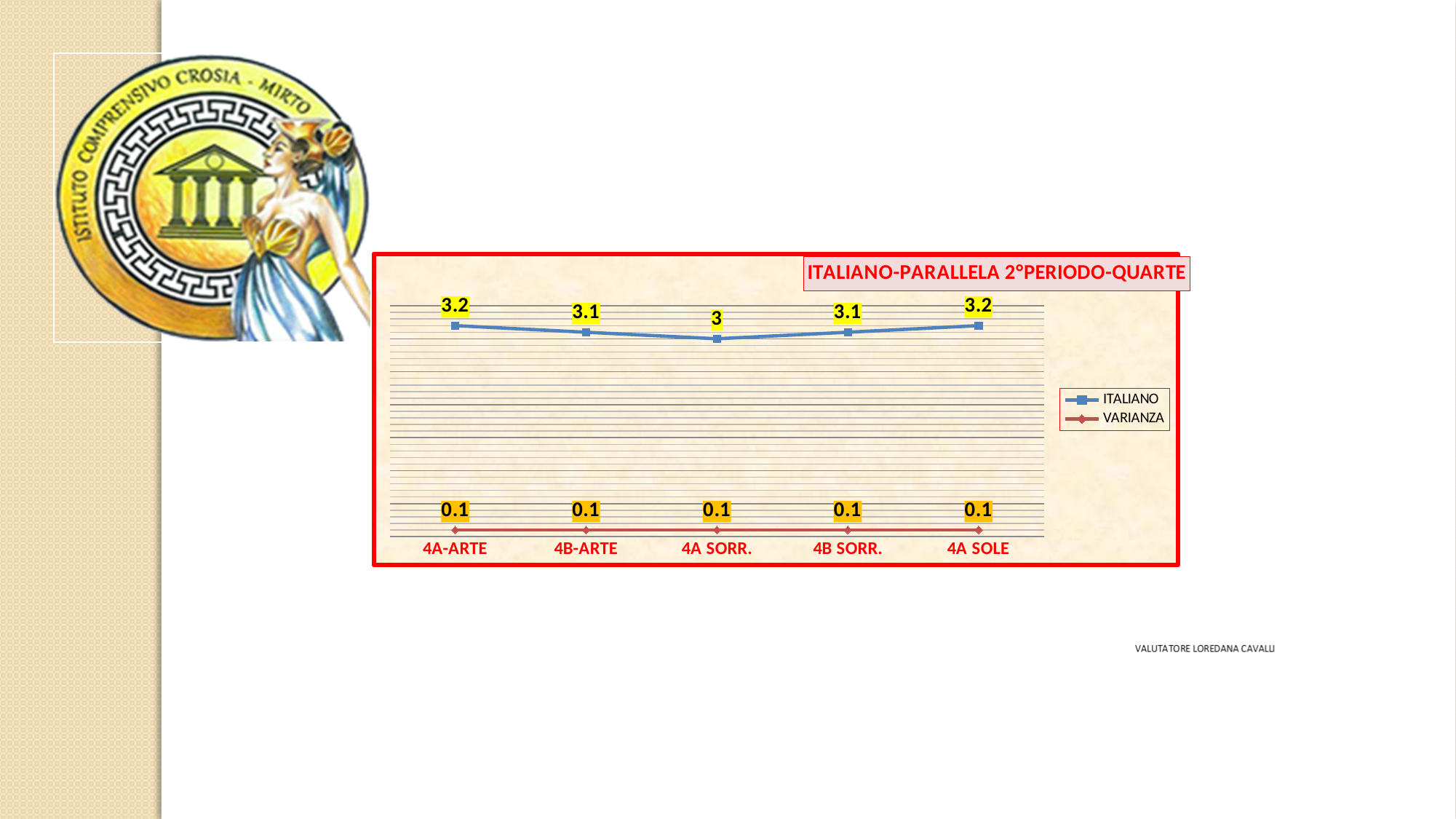
What kind of chart is shown on the slide? line chart What is the ITALIANO value for 4A SORR.? 3 What is the difference between the ITALIANO values for 4A-ARTE and 4A SORR.? 0.2 How many series does the legend list? 2 What is the ITALIANO value for 4B-ARTE? 3.1 Which is larger, the ITALIANO value for 4B SORR. or for 4A SOLE? 4A SOLE What is the title of the chart? ITALIANO-PARALLELA 2°PERIODO-QUARTE What is the VARIANZA value for 4A SOLE? 0.1 How many categories are shown on the x axis? 5 Which series is drawn in blue? ITALIANO Which category has the lowest ITALIANO value? 4A SORR. Does the VARIANZA series rise, fall or stay flat across the categories? stays flat